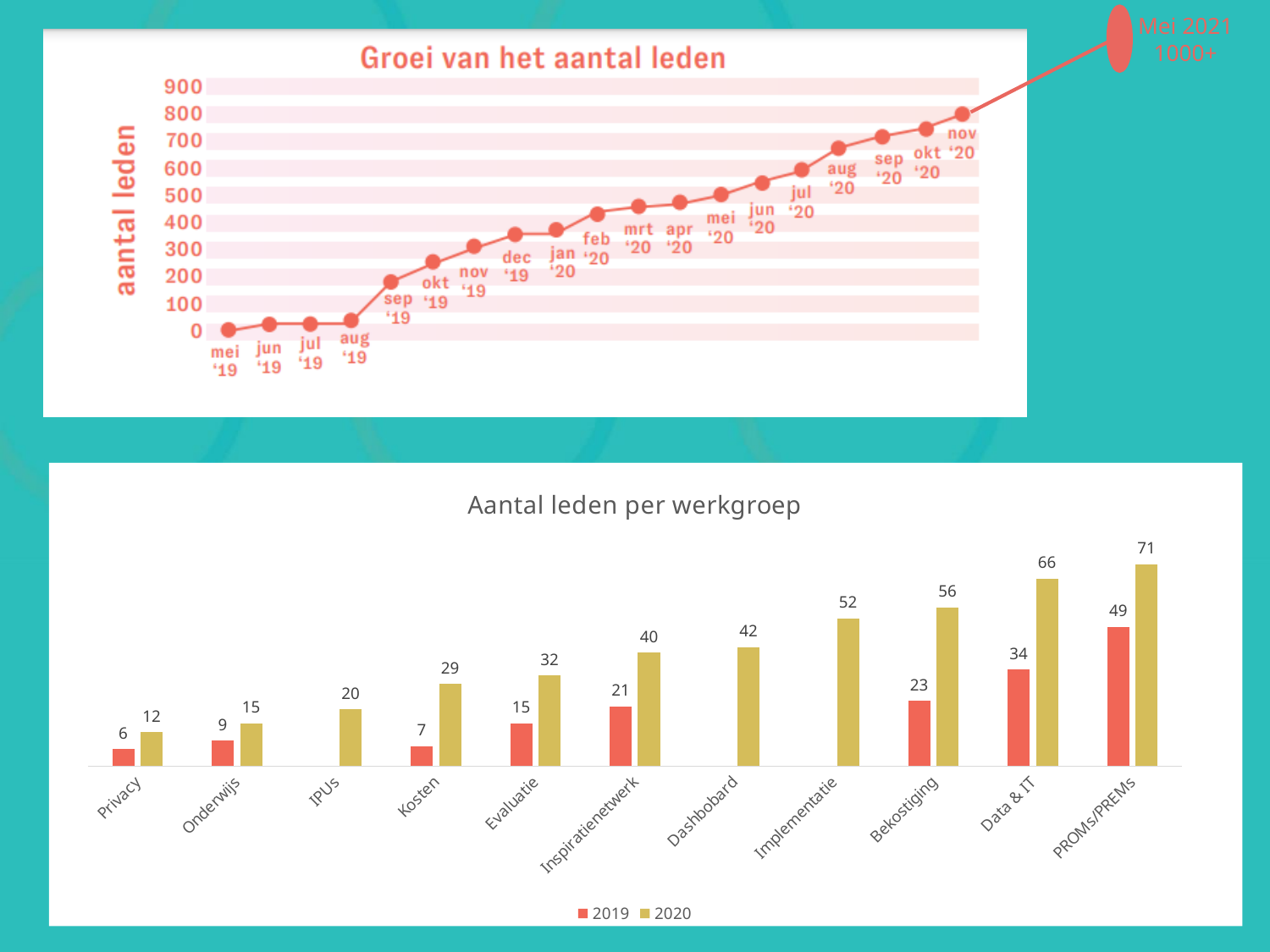
In the 'Groei van het aantal leden' chart, is the value for okt '20 greater or less than 700? greater In the 'Aantal leden per werkgroep' chart, which werkgroep has the lowest 2019 value? Privacy In the 'Groei van het aantal leden' chart, do the values rise or fall from mei '19 to nov '20? Rise In the 'Aantal leden per werkgroep' chart, which werkgroep has the highest 2020 value? PROMs/PREMs In the 'Aantal leden per werkgroep' chart, which is larger: the 2020 value for Dashboard or the 2020 value for Inspiratienetwerk? Dashboard In the 'Groei van het aantal leden' chart, is the value for sep '19 greater or less than 100? greater How many werkgroepen are shown on the x axis of the 'Aantal leden per werkgroep' chart? 11 In the 'Aantal leden per werkgroep' chart, what is the difference between the 2020 and 2019 values for Data & IT? 32 What kind of chart is 'Aantal leden per werkgroep'? Bar chart How many series does the legend of the 'Aantal leden per werkgroep' chart list? 2 In the 'Aantal leden per werkgroep' chart, what is the 2019 value for Inspiratienetwerk? 21 In the 'Aantal leden per werkgroep' chart, what is the 2020 value for Bekostiging? 56